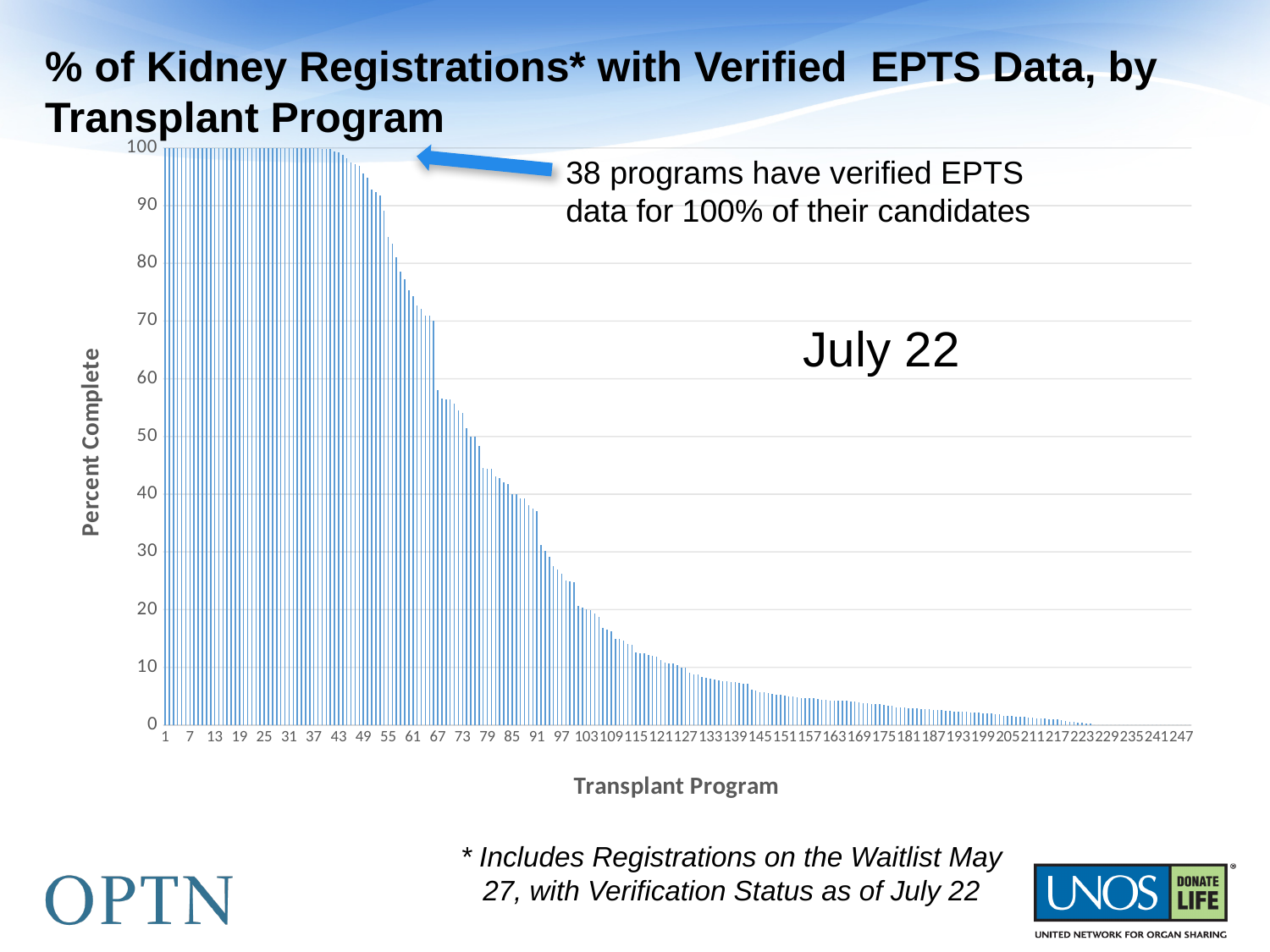
Is the value for transplant program 49 greater or less than 80? greater What is the label on the y axis of the chart? Percent Complete Do the values rise or fall as you move from left to right along the x axis? fall What kind of chart is shown on the slide? bar chart Is the value for transplant program 97 greater or less than 30? less According to the annotation on the chart, how many programs have verified EPTS data for 100% of their candidates? 38 Is the value for transplant program 199 greater or less than 10? less Which has the larger value, transplant program 13 or transplant program 133? transplant program 13 What is the percent complete for transplant program 1? 100